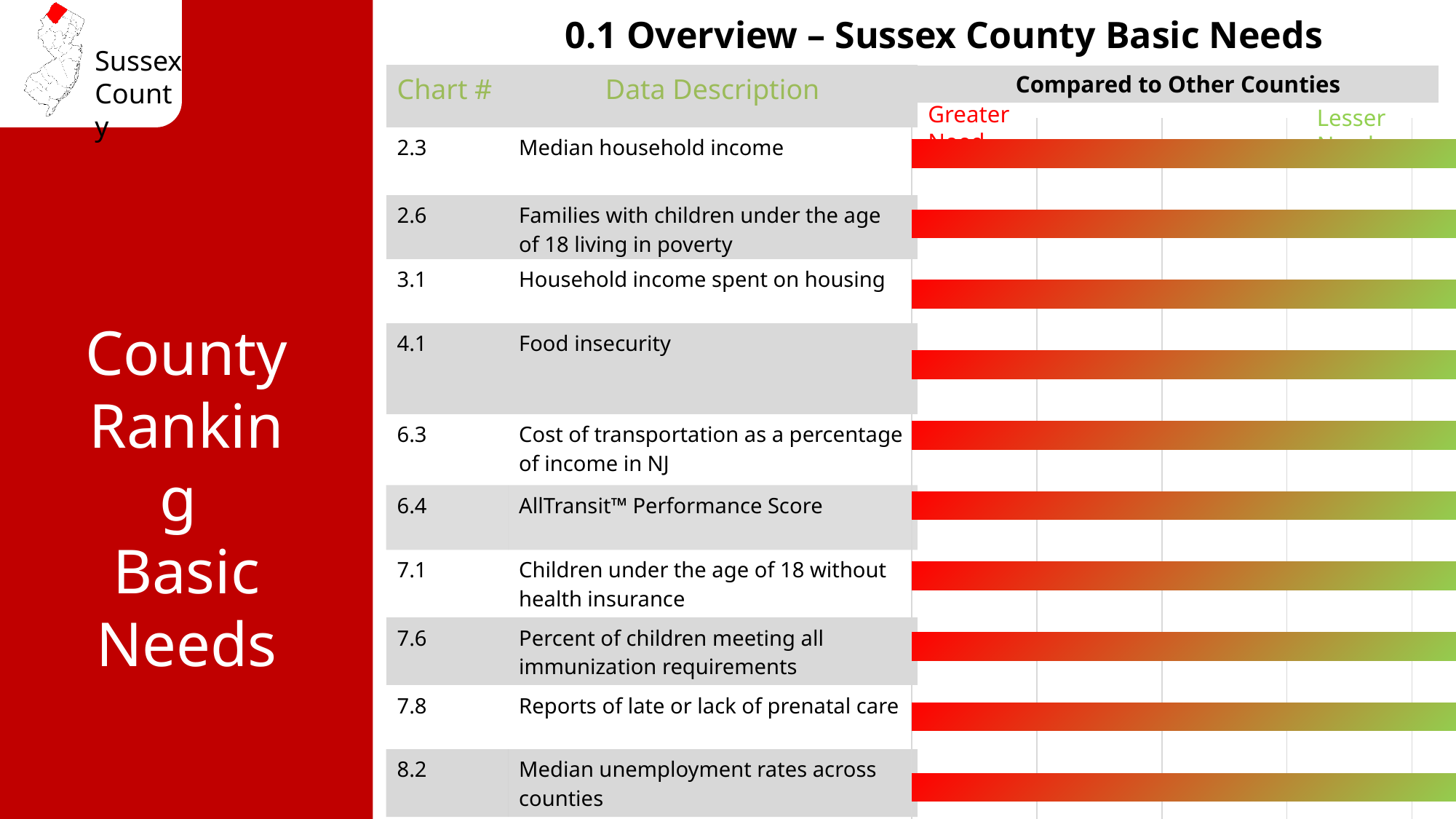
Which chart number is listed for AllTransit™ Performance Score? 6.4 Which chart number is listed for Food insecurity? 4.1 What is the header of the column containing the bars? Compared to Other Counties How many data description rows are plotted with bars on the slide? 10 What kind of chart is used to compare Sussex County to other counties on this slide? bar chart What is the title of the slide's chart? 0.1 Overview – Sussex County Basic Needs Which chart number is listed for Reports of late or lack of prenatal care? 7.8 Which chart number is listed for Median household income? 2.3